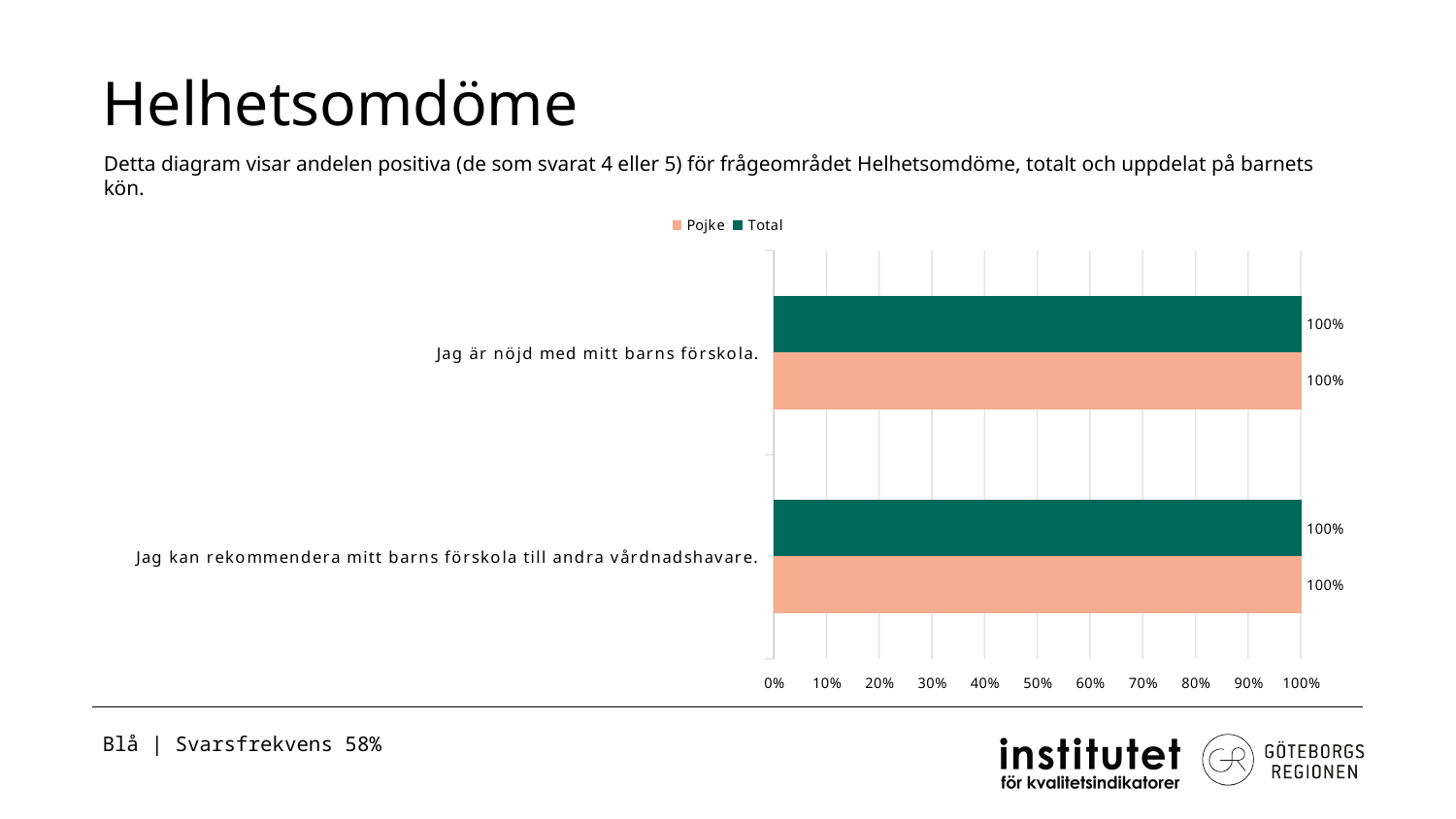
How many statements (categories) are shown in the chart? 2 What is the difference between the Pojke and Total values for "Jag är nöjd med mitt barns förskola."? 0% What is the value for Total for "Jag är nöjd med mitt barns förskola."? 100% Is the Pojke value for "Jag kan rekommendera mitt barns förskola till andra vårdnadshavare." greater or less than 50%? greater What are the two series named in the legend? Pojke and Total What is the title of the slide containing the chart? Helhetsomdöme What is the difference between the Total values for the two statements? 0% What kind of chart is shown on the slide? bar chart How many series does the legend list? 2 What is the value for Total for "Jag kan rekommendera mitt barns förskola till andra vårdnadshavare."? 100% What is the value for Pojke for "Jag är nöjd med mitt barns förskola."? 100% What is the value for Pojke for "Jag kan rekommendera mitt barns förskola till andra vårdnadshavare."? 100%